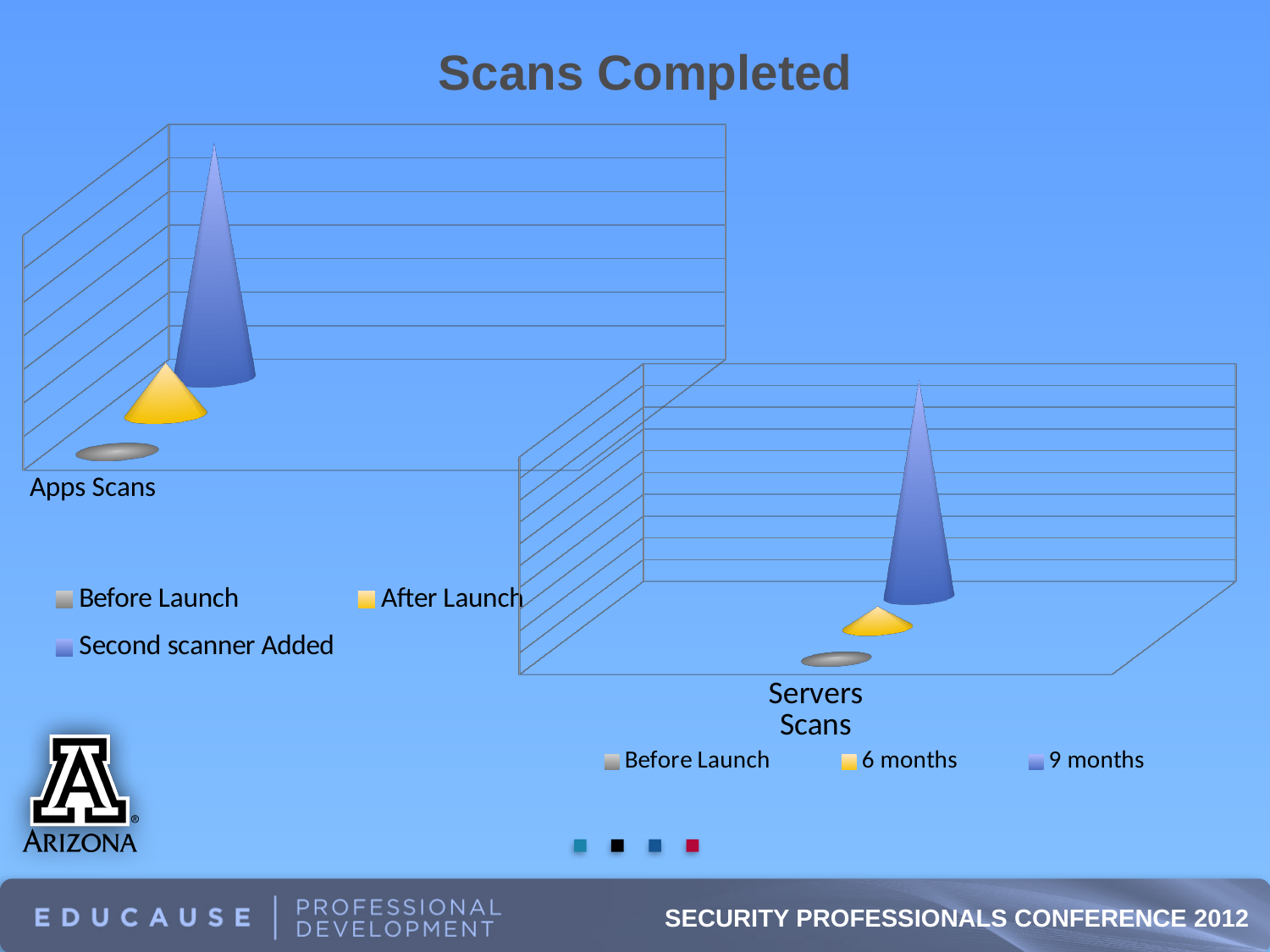
In the Servers Scans chart, how many series does the legend list? 3 In the Servers Scans chart, do the values rise or fall from Before Launch to 9 months? rise What is the title of the slide's charts? Scans Completed In the Servers Scans chart, which series has the highest value? 9 months In the Servers Scans chart, what are the three legend entries? Before Launch, 6 months, 9 months In the Apps Scans chart, which series has the highest value? Second scanner Added In the Apps Scans chart, which is larger: After Launch or Second scanner Added? Second scanner Added In the Servers Scans chart, which series has the lowest value? Before Launch How many charts are shown on the slide? 2 In the Apps Scans chart, how many series does the legend list? 3 In the Servers Scans chart, which is larger: Before Launch or 6 months? 6 months In the Apps Scans chart, which series has the lowest value? Before Launch